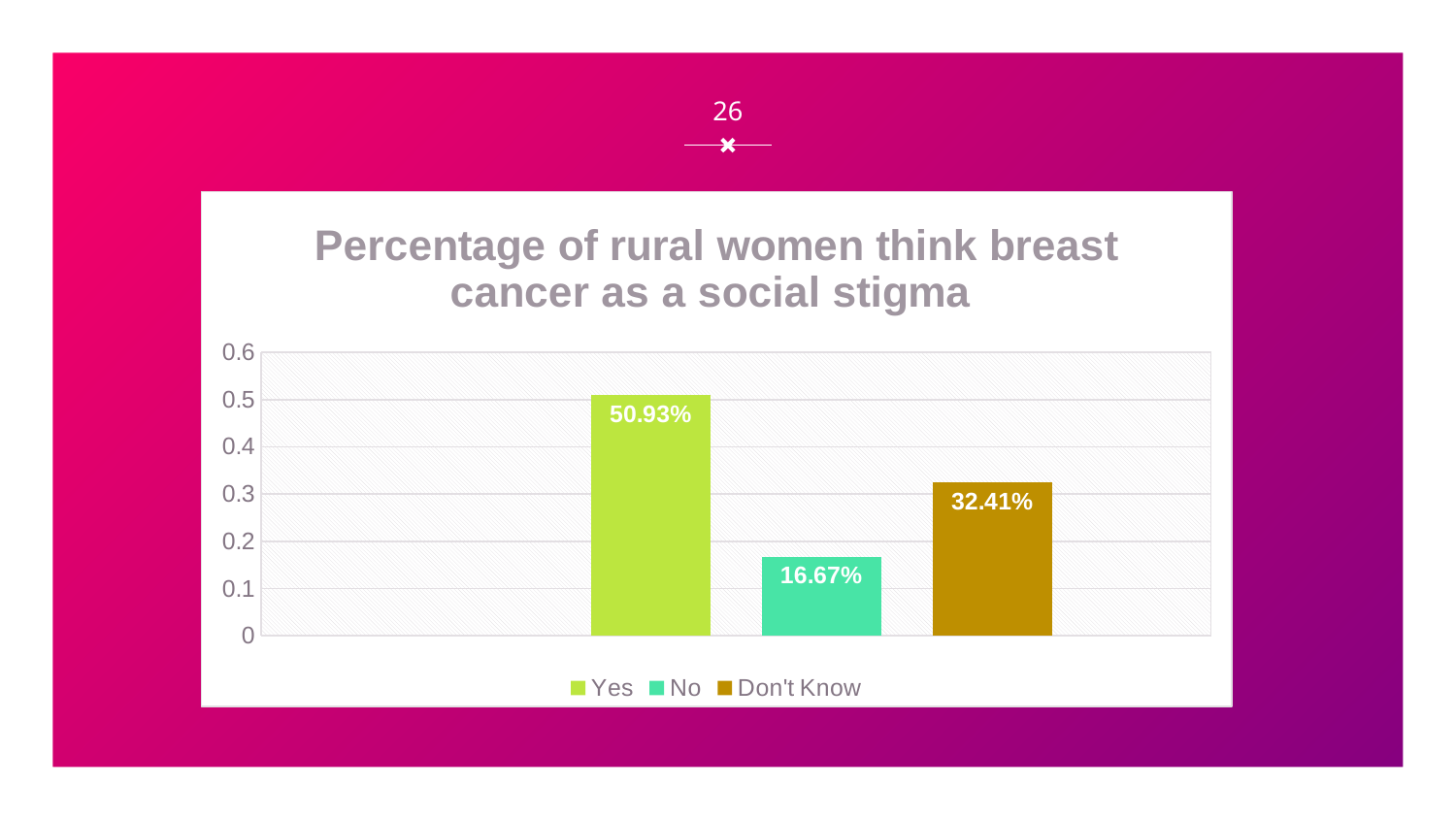
What is the title of the chart? Percentage of rural women think breast cancer as a social stigma How many response categories are shown in the chart? 3 What is the difference between the "Yes" and "No" percentages? 34.26% What percentage of rural women answered "Yes" to thinking breast cancer is a social stigma? 50.93% What is the value shown for the "No" bar? 16.67% What type of chart is shown on the slide? Bar chart Is the value for "Yes" greater or less than 0.4? greater What is the difference between the "Don't Know" and "No" percentages? 15.74% What is the value shown for the "Don't Know" bar? 32.41% Which response category has the highest percentage? Yes Which response category has the lowest percentage? No Which is larger, the "Don't Know" value or the "No" value? Don't Know